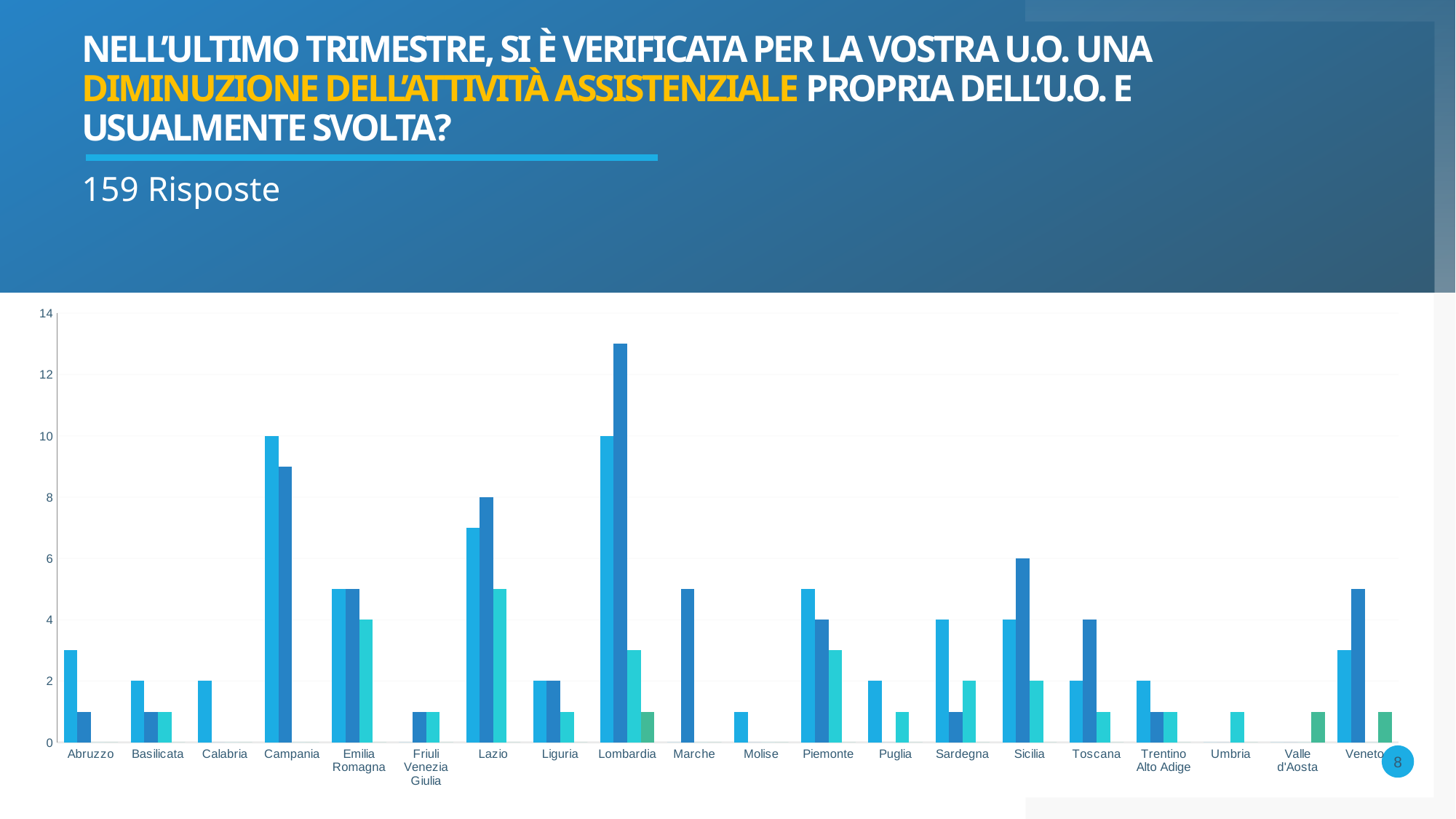
How many regions are listed along the x axis of the chart? 20 What is the value of the second (dark blue) bar for Lazio? 8 Which is larger: the first (light blue) bar for Campania or the first (light blue) bar for Lazio? Campania What is the value of the second (dark blue) bar for Sicilia? 6 What is the value of the third (teal) bar for Emilia Romagna? 4 Which region has the tallest bar in the chart? Lombardia Is the value of the second (dark blue) bar for Lombardia greater or less than 12? greater What is the value of the first (light blue) bar for Sardegna? 4 What is the value of the first (light blue) bar for Campania? 10 What kind of chart is shown on the slide? bar chart Is the value of the second (dark blue) bar for Campania greater or less than 8? greater What is the difference between the second (dark blue) bar for Lazio and the second (dark blue) bar for Sicilia? 2